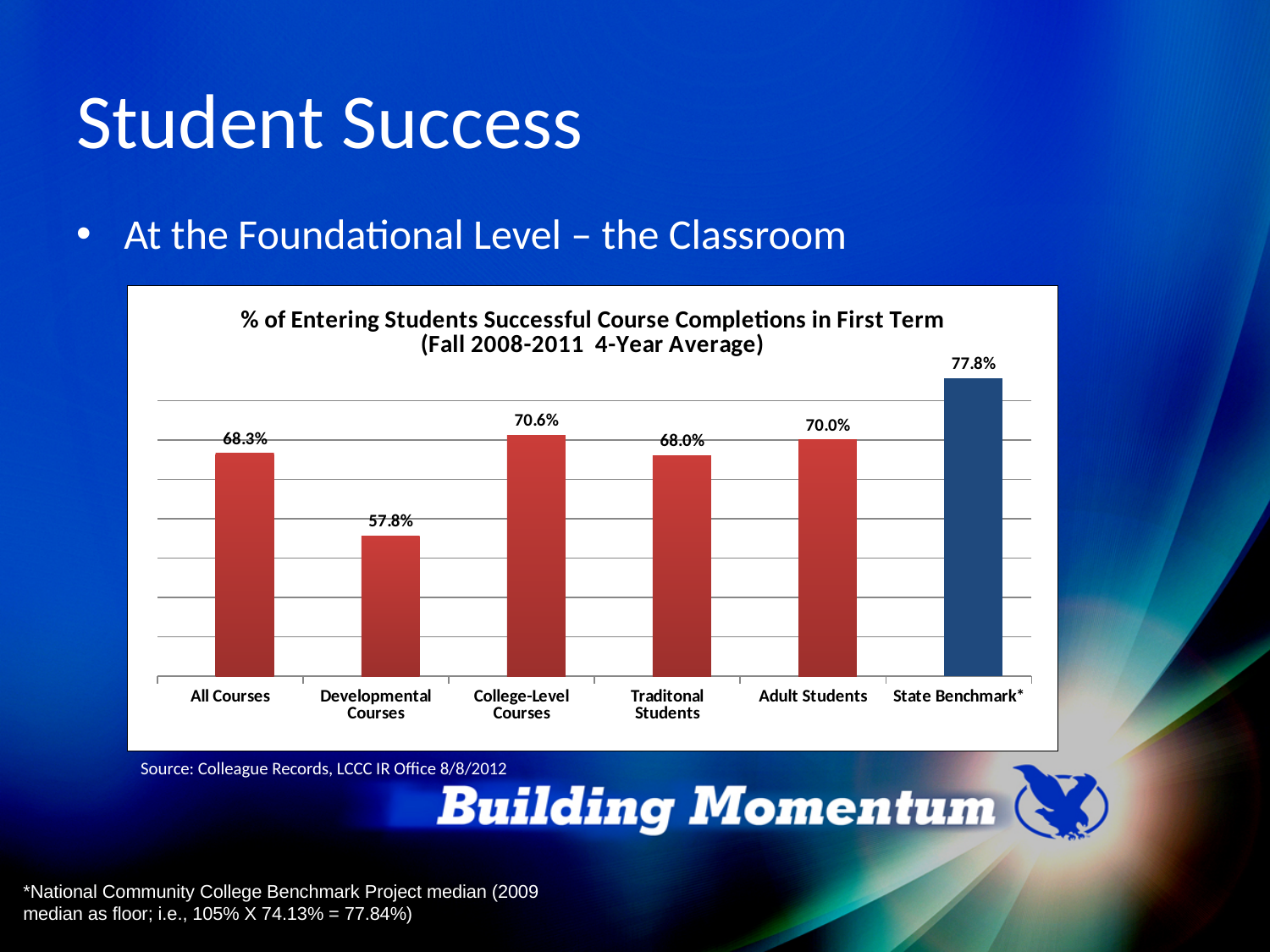
What kind of chart is shown? Bar chart Which bar is coloured differently from the others? State Benchmark* What is the difference between the State Benchmark* and Developmental Courses? 20.0 percentage points Which category has the lowest value? Developmental Courses How many categories are shown on the chart? 6 What is the value for the State Benchmark*? 77.8% Which is larger, the value for College-Level Courses or the value for Adult Students? College-Level Courses What is the value for Adult Students? 70.0% Which category has the highest value? State Benchmark* What is the value for Developmental Courses? 57.8% What is the value for All Courses? 68.3% What is the difference between College-Level Courses and Traditonal Students? 2.6 percentage points